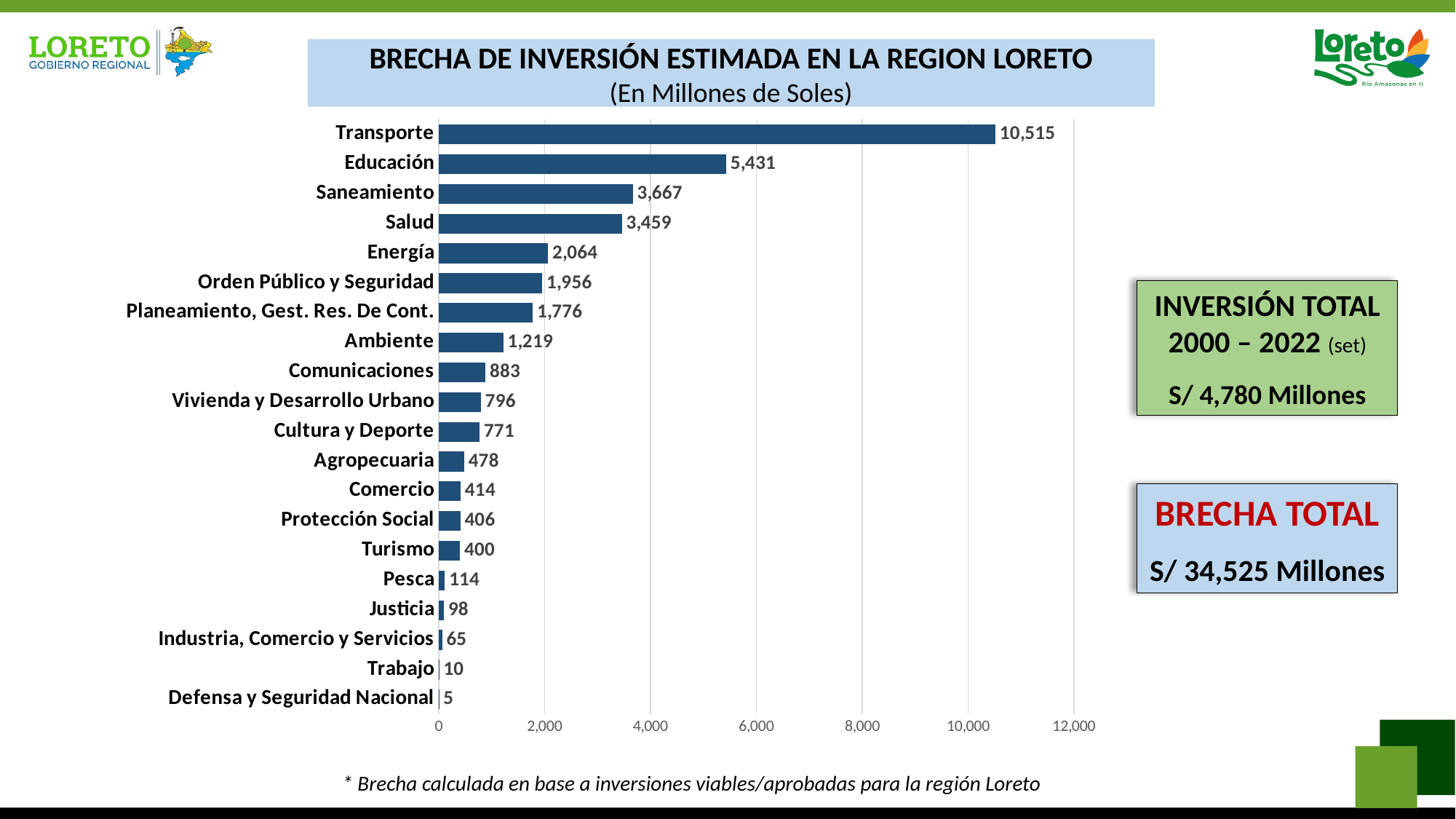
What is the value for Transporte? 10,515 What is the difference between the values for Saneamiento and Salud? 208 What is the title of the chart? BRECHA DE INVERSIÓN ESTIMADA EN LA REGION LORETO (En Millones de Soles) What kind of chart is shown on the slide? bar chart Which is larger, the value for Energía or the value for Orden Público y Seguridad? Energía Is the value for Educación greater or less than 4,000? greater What is the difference between the values for Transporte and Educación? 5,084 What is the value for Saneamiento? 3,667 Which category has the highest value? Transporte What is the value for Comunicaciones? 883 Which category has the lowest value? Defensa y Seguridad Nacional How many categories are shown in the chart? 20